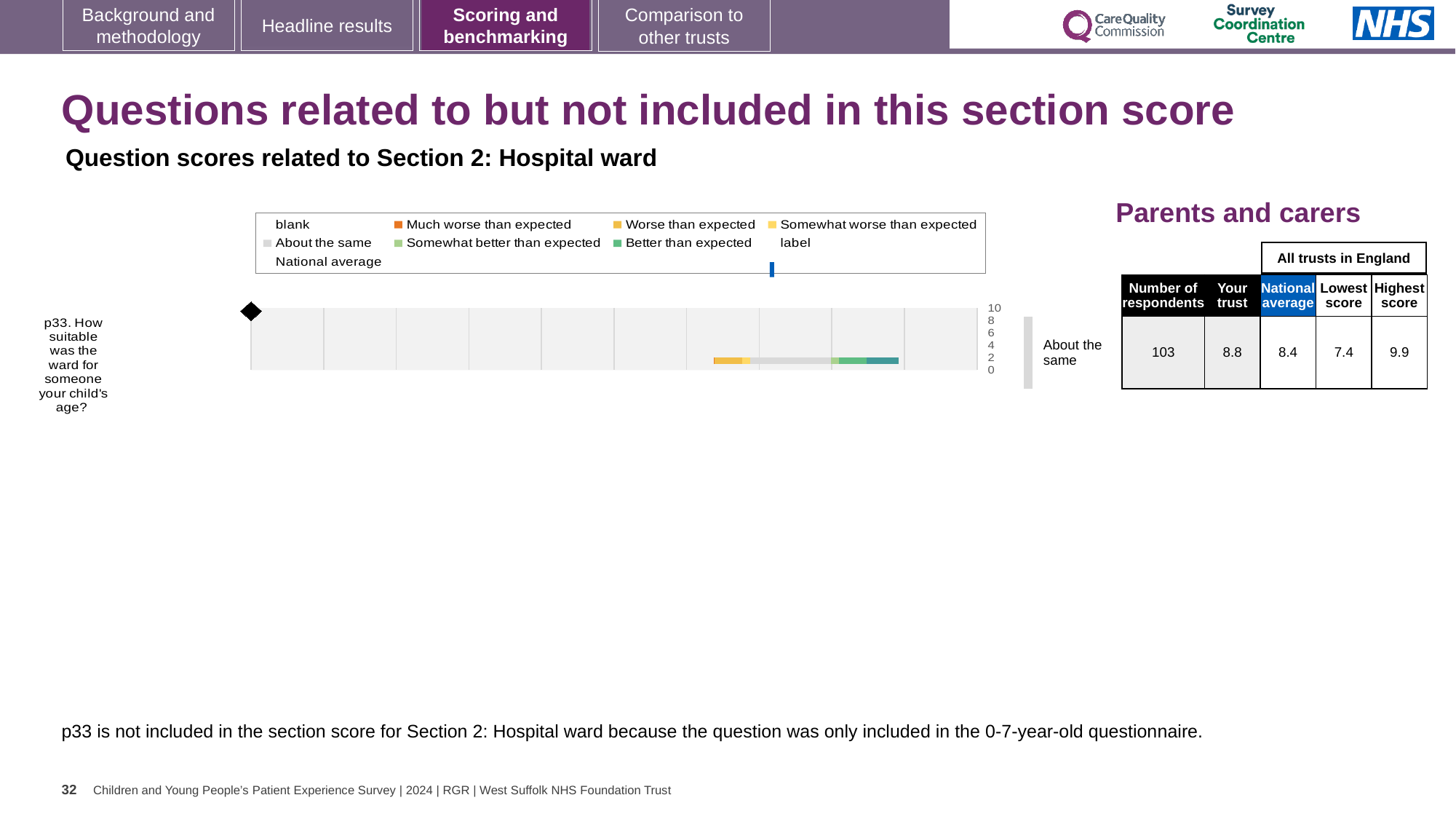
What is the 'Your trust' score for question p33 in the Parents and carers table? 8.8 Which is larger for question p33: the 'Your trust' score or the national average? Your trust Which legend entry is shown in orange? Much worse than expected What is the national average score for question p33? 8.4 How many respondents answered question p33? 103 How many questions (categories) are plotted in the chart? 1 What is the highest value shown on the chart's axis? 10 What is the highest score among all trusts in England for question p33? 9.9 What is the difference between the highest score and the lowest score for question p33? 2.5 What kind of chart is used to show the result for question p33? bar chart What is the lowest score among all trusts in England for question p33? 7.4 What benchmark result is shown next to the bar for question p33? About the same